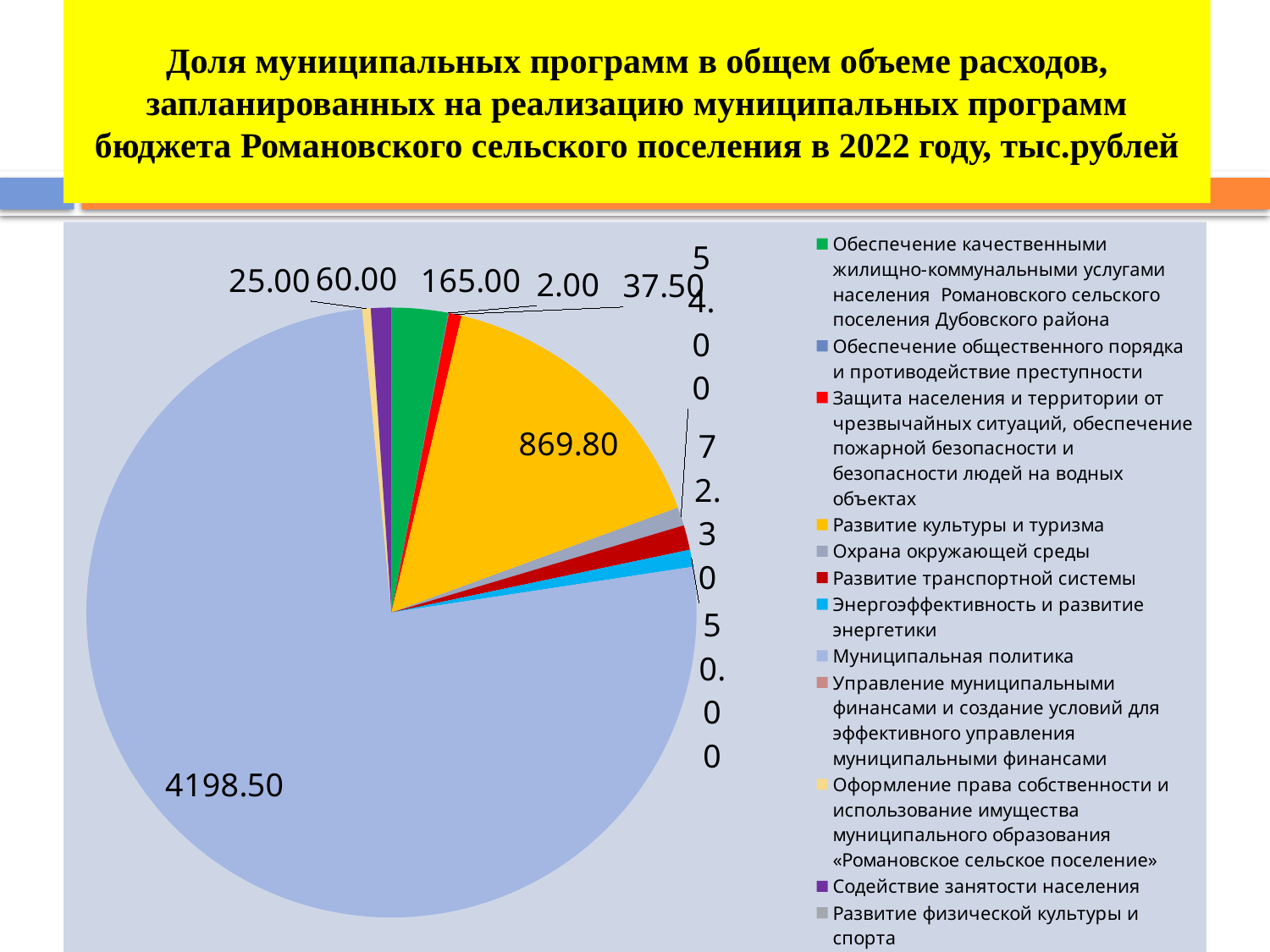
What is the value shown for «Развитие культуры и туризма»? 869.80 How many programmes does the legend of the pie chart list? 12 Which is larger: the value for «Развитие культуры и туризма» or the value for «Обеспечение качественными жилищно-коммунальными услугами...»? Развитие культуры и туризма Which programme has the largest share of the pie chart? Муниципальная политика What is the smallest value labelled on the pie chart? 2.00 What kind of chart is shown on the slide? pie chart What colour is the slice for «Развитие культуры и туризма»? yellow What is the value shown for «Обеспечение качественными жилищно-коммунальными услугами населения Романовского сельского поселения Дубовского района»? 165.00 What is the difference between the value for «Муниципальная политика» (4198.50) and the value for «Развитие культуры и туризма» (869.80)? 3328.70 What is the value shown for «Содействие занятости населения»? 60.00 What is the value of the largest slice of the pie chart? 4198.50 What is the value shown for «Защита населения и территории от чрезвычайных ситуаций...»? 37.50